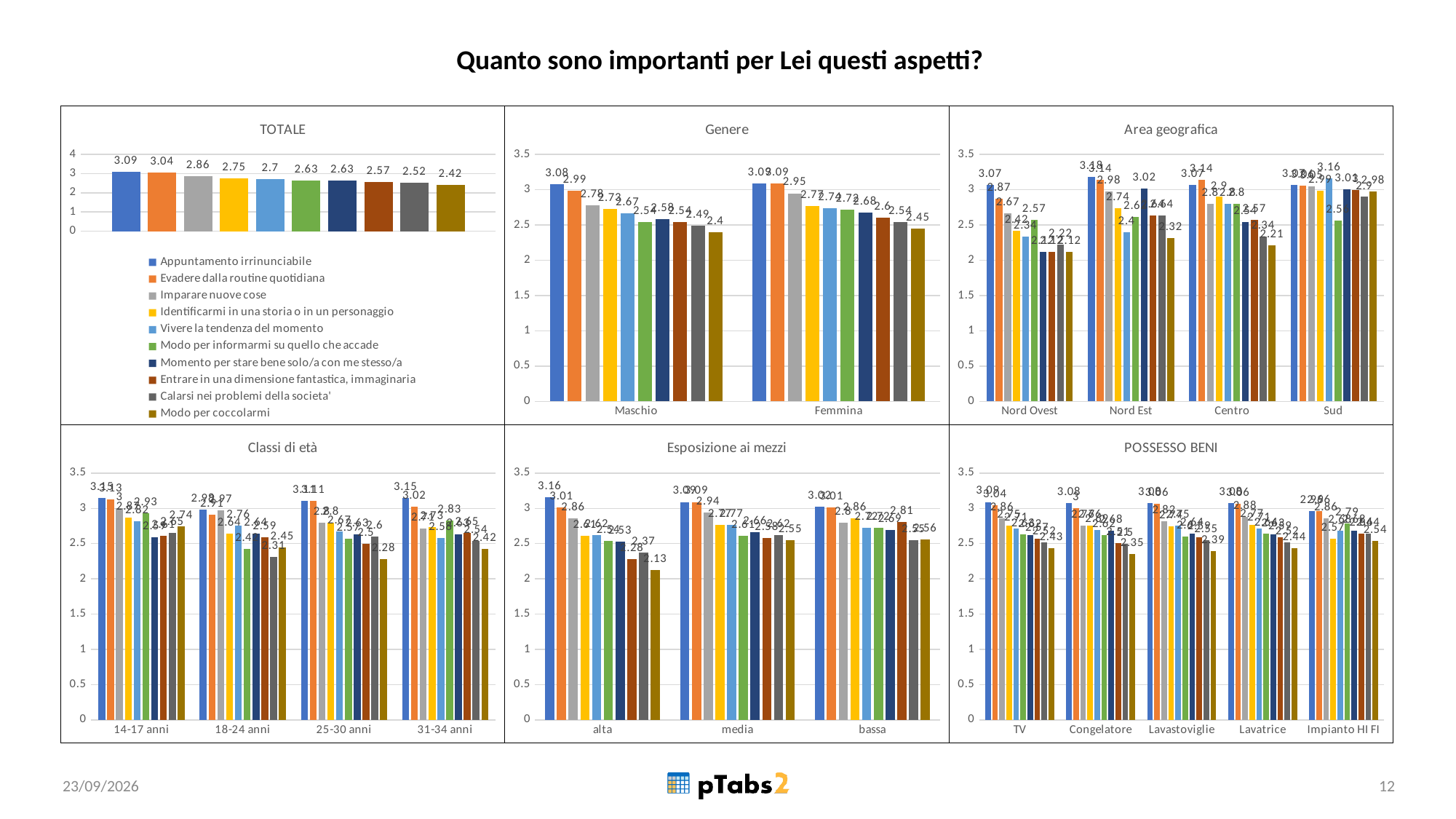
In the Genere chart, what is the value of Modo per coccolarmi for Femmina? 2.45 In the Area geografica chart, what is the value of Modo per coccolarmi for Sud? 2.98 How many categories are shown on the x axis of the POSSESSO BENI chart? 5 In the Genere chart, what is the value of Appuntamento irrinunciabile for Maschio? 3.08 In the Area geografica chart, is the value of Modo per coccolarmi for Nord Ovest greater or less than 2.5? less How many series does the legend in the TOTALE chart list? 10 In the Classi di età chart, what is the value of Modo per coccolarmi for 25-30 anni? 2.28 In the TOTALE chart, what is the value for Modo per coccolarmi? 2.42 In the TOTALE chart, which aspect has the highest value? Appuntamento irrinunciabile In the TOTALE chart, what is the difference between Appuntamento irrinunciabile and Modo per coccolarmi? 0.67 In the TOTALE chart, what is the value for Appuntamento irrinunciabile? 3.09 In the Esposizione ai mezzi chart, what is the value of Appuntamento irrinunciabile for alta? 3.16